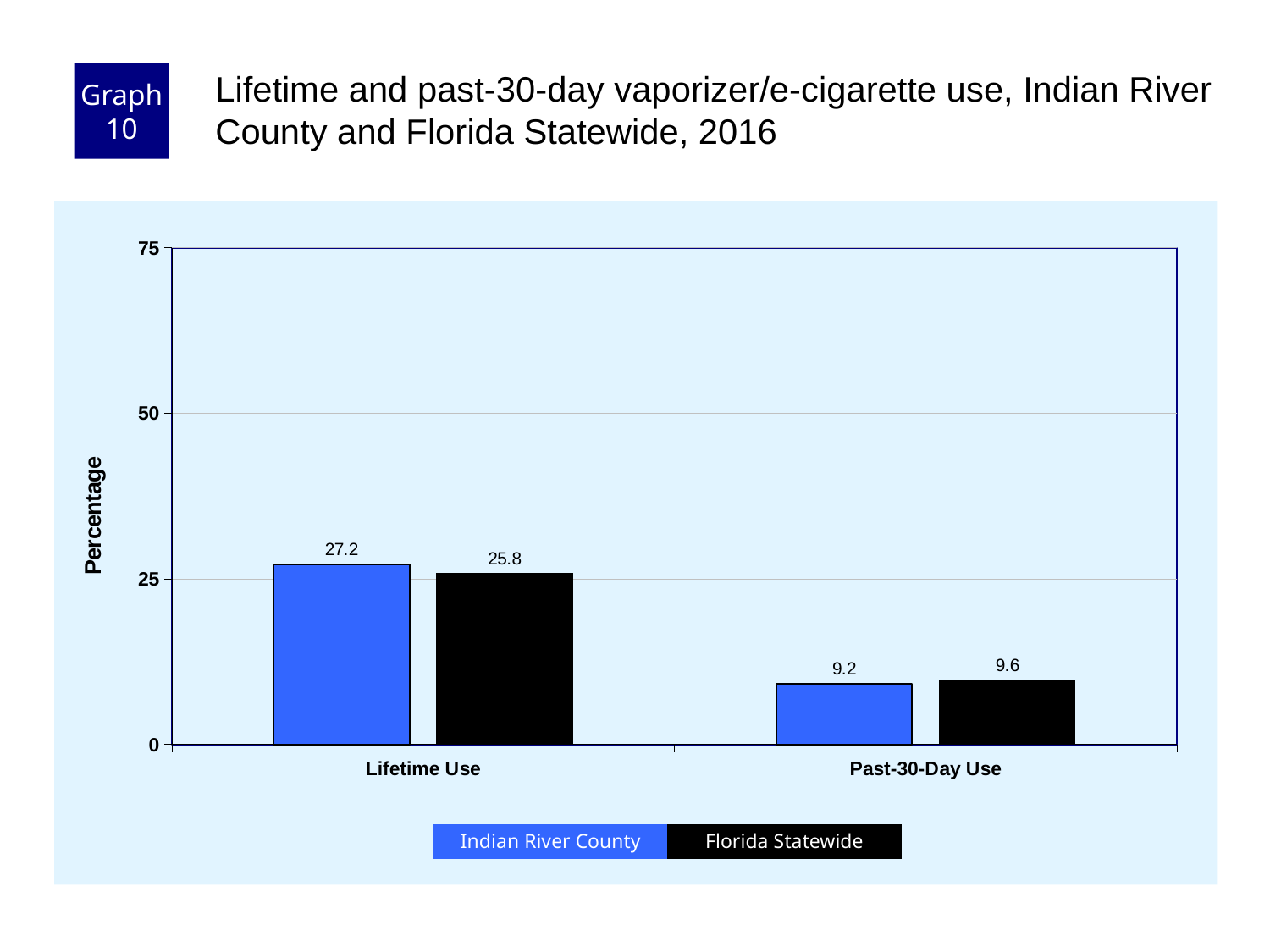
What is the Past-30-Day Use value for Florida Statewide? 9.6 How many categories are shown on the x axis? 2 What is the difference between the Indian River County and Florida Statewide values for Lifetime Use? 1.4 What is the Past-30-Day Use value for Indian River County? 9.2 Which bar has the lowest value on the chart? Indian River County, Past-30-Day Use What kind of chart is shown on the slide? bar chart Which bar has the highest value on the chart? Indian River County, Lifetime Use How many series does the legend list? 2 Is the Lifetime Use value for Florida Statewide greater or less than 25? greater What is the Lifetime Use value for Florida Statewide? 25.8 What is the Lifetime Use value for Indian River County? 27.2 For Past-30-Day Use, which is larger: Indian River County or Florida Statewide? Florida Statewide